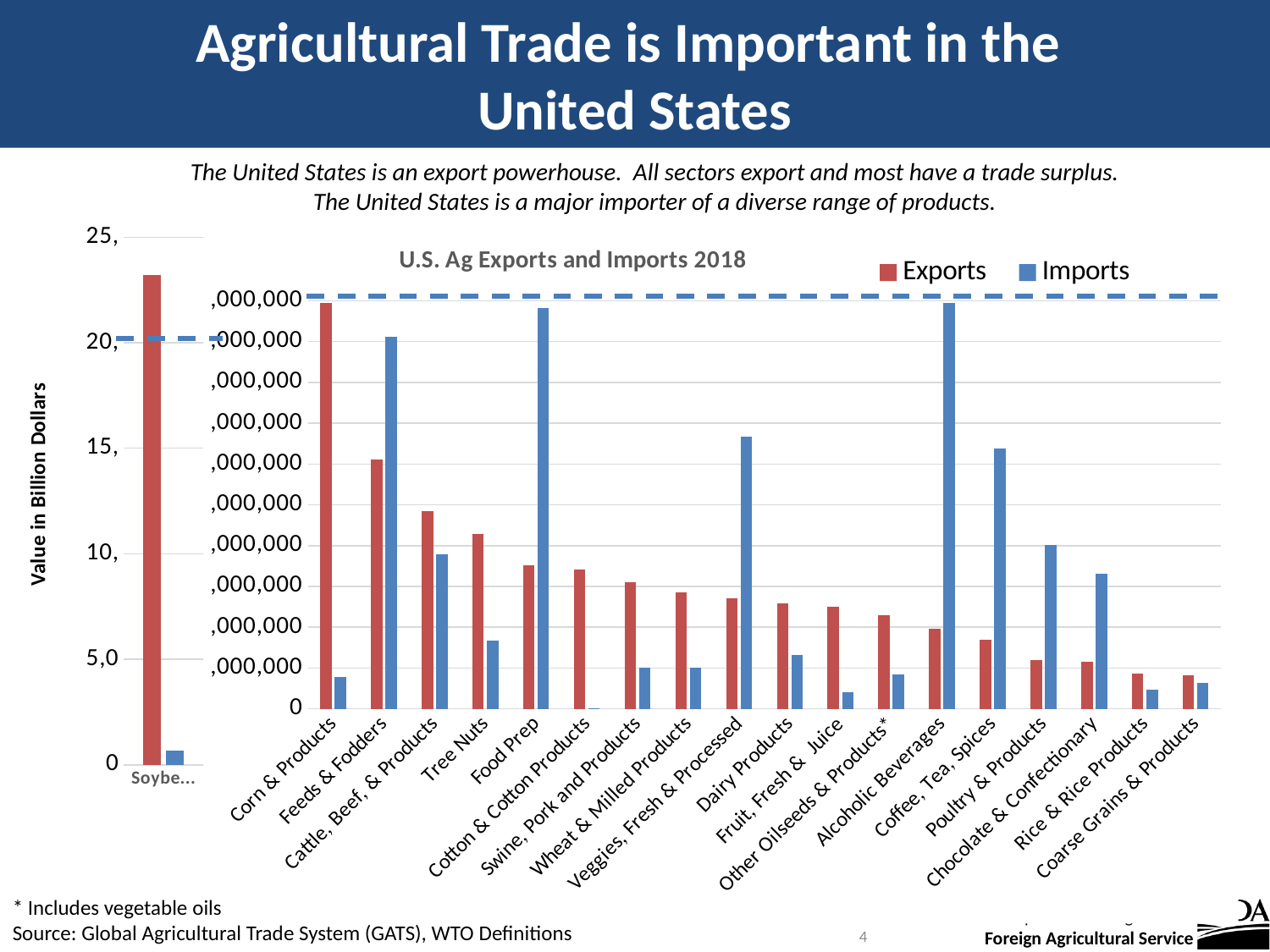
In the main chart 'U.S. Ag Exports and Imports 2018', for Coffee, Tea, Spices, which is larger: Exports or Imports? Imports In the main chart 'U.S. Ag Exports and Imports 2018', what kind of chart is used? bar chart In the main chart 'U.S. Ag Exports and Imports 2018', which category has the lowest Imports value? Cotton & Cotton Products In the main chart 'U.S. Ag Exports and Imports 2018', which colour represents Imports? blue What is the title of the main chart on the slide? U.S. Ag Exports and Imports 2018 In the main chart 'U.S. Ag Exports and Imports 2018', which category has the highest Exports value? Corn & Products In the small chart on the left of the slide, which is larger: the Exports bar or the Imports bar? Exports In the main chart 'U.S. Ag Exports and Imports 2018', do the Exports values generally rise or fall from left to right along the x axis? fall In the main chart 'U.S. Ag Exports and Imports 2018', for Feeds & Fodders, which is larger: Exports or Imports? Imports In the main chart 'U.S. Ag Exports and Imports 2018', how many product categories are shown on the x axis? 18 In the main chart 'U.S. Ag Exports and Imports 2018', how many series does the legend list? 2